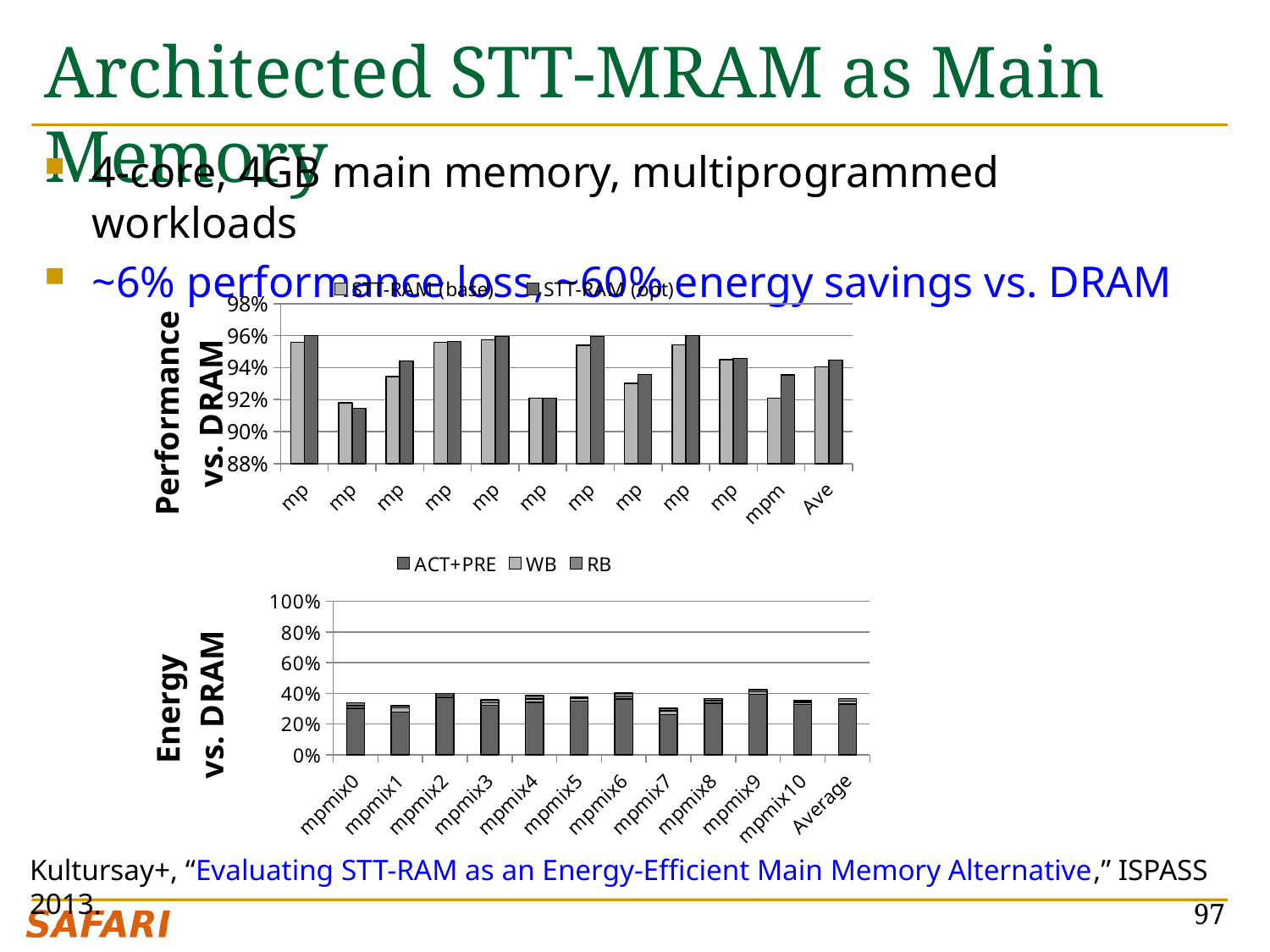
What is the y-axis title of the top chart? Performance vs. DRAM What are the legend entries of the bottom chart (Energy vs. DRAM)? ACT+PRE, WB, RB In the bottom chart (Energy vs. DRAM), is the total stacked value for mpmix7 greater or less than 20%? greater How many categories are shown on the x axis of the bottom chart (Energy vs. DRAM)? 12 In the bottom chart (Energy vs. DRAM), which has a larger total stacked value, mpmix9 or mpmix7? mpmix9 In the bottom chart (Energy vs. DRAM), is the total stacked value for mpmix9 greater or less than 60%? less In the top chart (Performance vs. DRAM), is the STT-RAM (opt) value for Ave greater or less than 96%? less How many series does the legend of the top chart (Performance vs. DRAM) list? 2 How many series does the legend of the bottom chart (Energy vs. DRAM) list? 3 What kind of chart is the bottom chart (Energy vs. DRAM)? bar chart